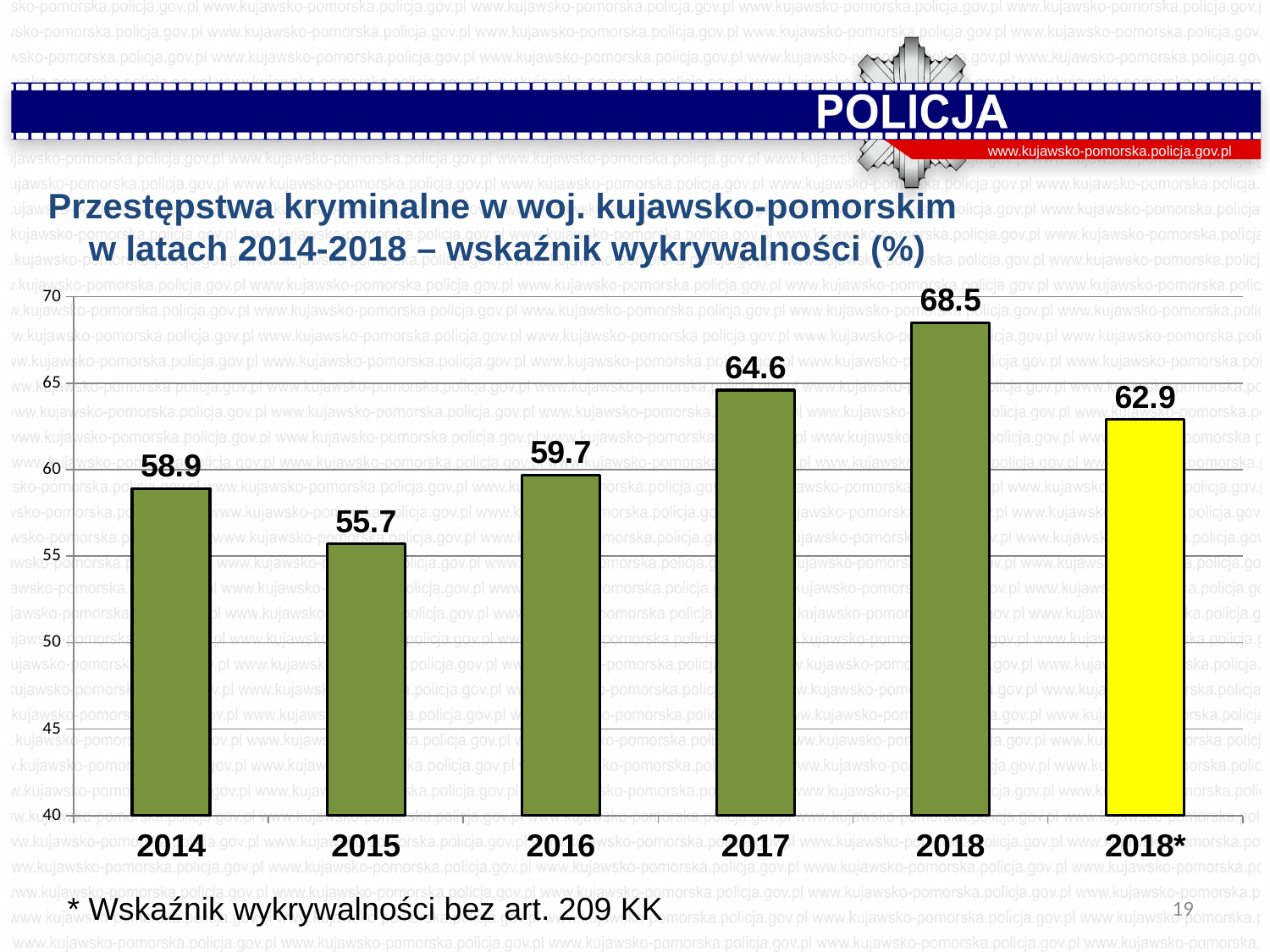
How many bars are plotted on the chart? 6 What kind of chart is shown on the slide? bar chart Which is larger, the value for 2014 or the value for 2016? 2016 Which year has the lowest value on the chart? 2015 Is the value for 2018 greater or less than 65? greater What is the detection rate (wskaźnik wykrywalności) shown for 2014? 58.9 What value is shown for the bar labelled 2018*? 62.9 What is the difference between the values for 2016 and 2015? 4.0 Which year has the highest value on the chart? 2018 What value is shown for 2017? 64.6 Which bar is coloured yellow instead of green? 2018* What is the difference between the values for 2018 and 2017? 3.9